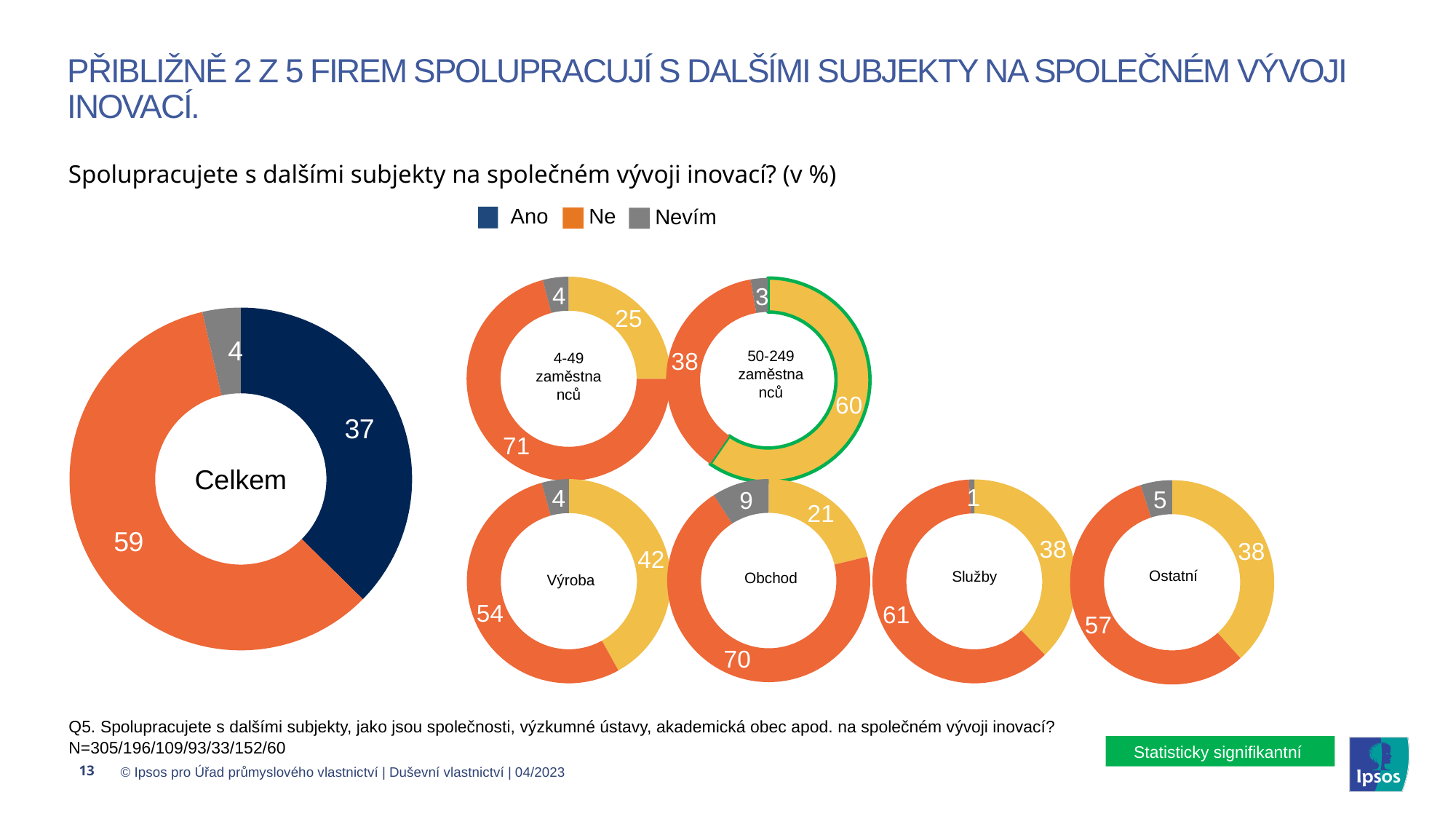
In the Celkem donut chart, what is the difference between the Ne value and the Ano value? 22 In the 4-49 zaměstnanců donut chart, what is the value of the orange (Ne) segment? 71 How many series does the legend list? 3 Is the orange (Ne) value in the Výroba donut chart larger or smaller than the orange (Ne) value in the Ostatní donut chart? smaller In the Celkem donut chart, what is the value for Ne? 59 In the Celkem donut chart, what is the value for Nevím? 4 Which donut chart has the largest grey (Nevím) segment value? Obchod Which donut chart has the smallest grey (Nevím) segment value? Služby In the Služby donut chart, what is the value of the orange (Ne) segment? 61 In the Celkem donut chart, what is the value for Ano? 37 In the Obchod donut chart, what is the value of the grey (Nevím) segment? 9 In the 50-249 zaměstnanců donut chart, what is the value of the yellow segment? 60